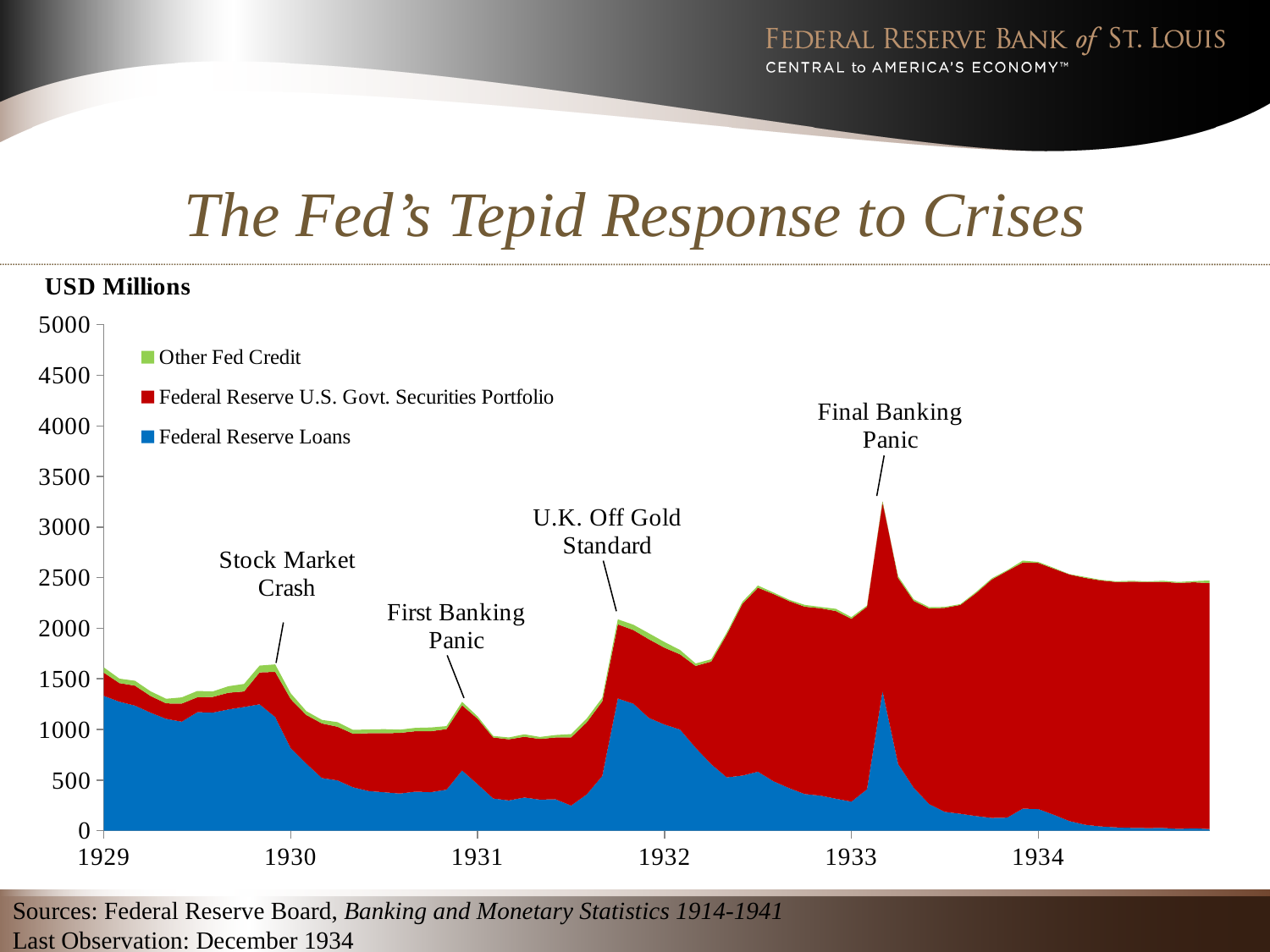
Is the total Fed credit at the Final Banking Panic peak greater or less than 3500? less What unit is shown for the vertical axis of the chart? USD Millions Is the total Fed credit at the First Banking Panic peak greater or less than 1500? less Is the total Fed credit at the Stock Market Crash peak greater or less than 2000? less Do Federal Reserve Loans rise or fall from the Final Banking Panic peak to the end of 1934? Fall What is the title of the slide's chart? The Fed's Tepid Response to Crises Which annotated event coincides with the highest peak in total Fed credit? Final Banking Panic How many series does the chart's legend list? 3 Which series is shown in blue in the chart? Federal Reserve Loans What kind of chart is shown on the slide? Stacked area chart How many crisis events are annotated on the chart? 4